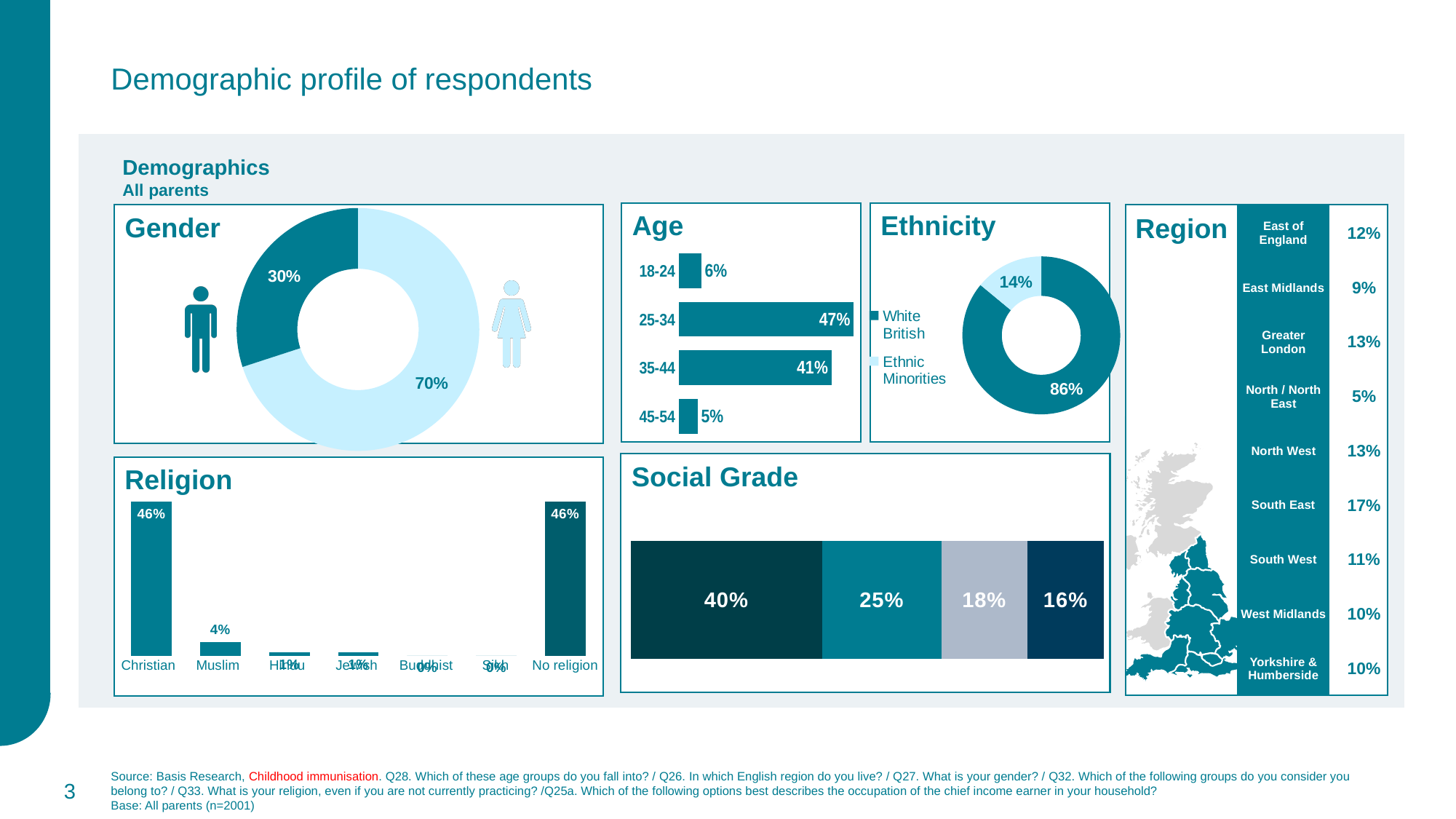
In the Age chart, which age group has the lowest percentage? 45-54 In the Gender chart, what is the value of the larger slice? 70% In the Social Grade chart, what is the value of the largest segment? 40% In the Religion chart, what percentage of respondents are Muslim? 4% In the Ethnicity chart, what percentage of respondents are White British? 86% What type of chart is the Gender chart? Donut chart In the Age chart, what percentage of respondents are aged 25-34? 47% What type of chart is the Religion chart? Bar chart In the Religion chart, which is larger, Christian or Muslim? Christian In the Ethnicity chart, how many entries does the legend list? 2 In the Age chart, what is the difference between the 25-34 and 35-44 percentages? 6 percentage points In the Age chart, how many age groups are shown? 4